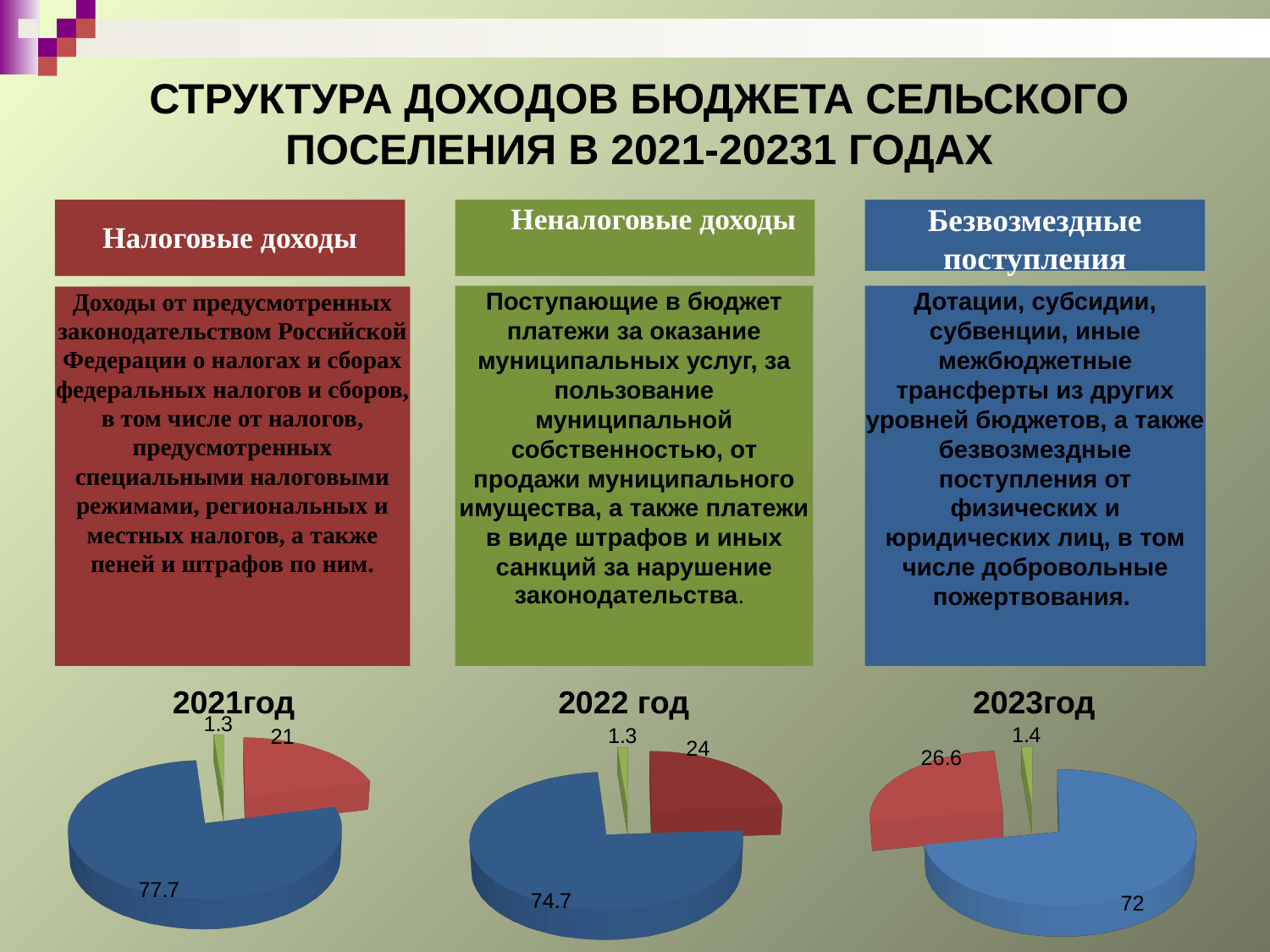
In the 2022 год pie chart, what is the value of the blue slice? 74.7 In the 2021год pie chart, what is the value of the largest slice? 77.7 How many slices does the 2023год pie chart have? 3 Which is larger: the blue slice in the 2021год chart or the blue slice in the 2023год chart? 2021год What kind of chart is used for the 2021год chart? pie chart In the 2021год pie chart, what is the value of the smallest slice? 1.3 In the 2022 год pie chart, what is the value of the red slice? 24 In the 2023год pie chart, what is the value of the red slice? 26.6 In the 2023год pie chart, what is the value of the smallest slice? 1.4 How many pie charts are shown on the slide? 3 What is the difference between the red slice in the 2023год chart and the red slice in the 2021год chart? 5.6 In the 2021год pie chart, what is the value of the red slice? 21